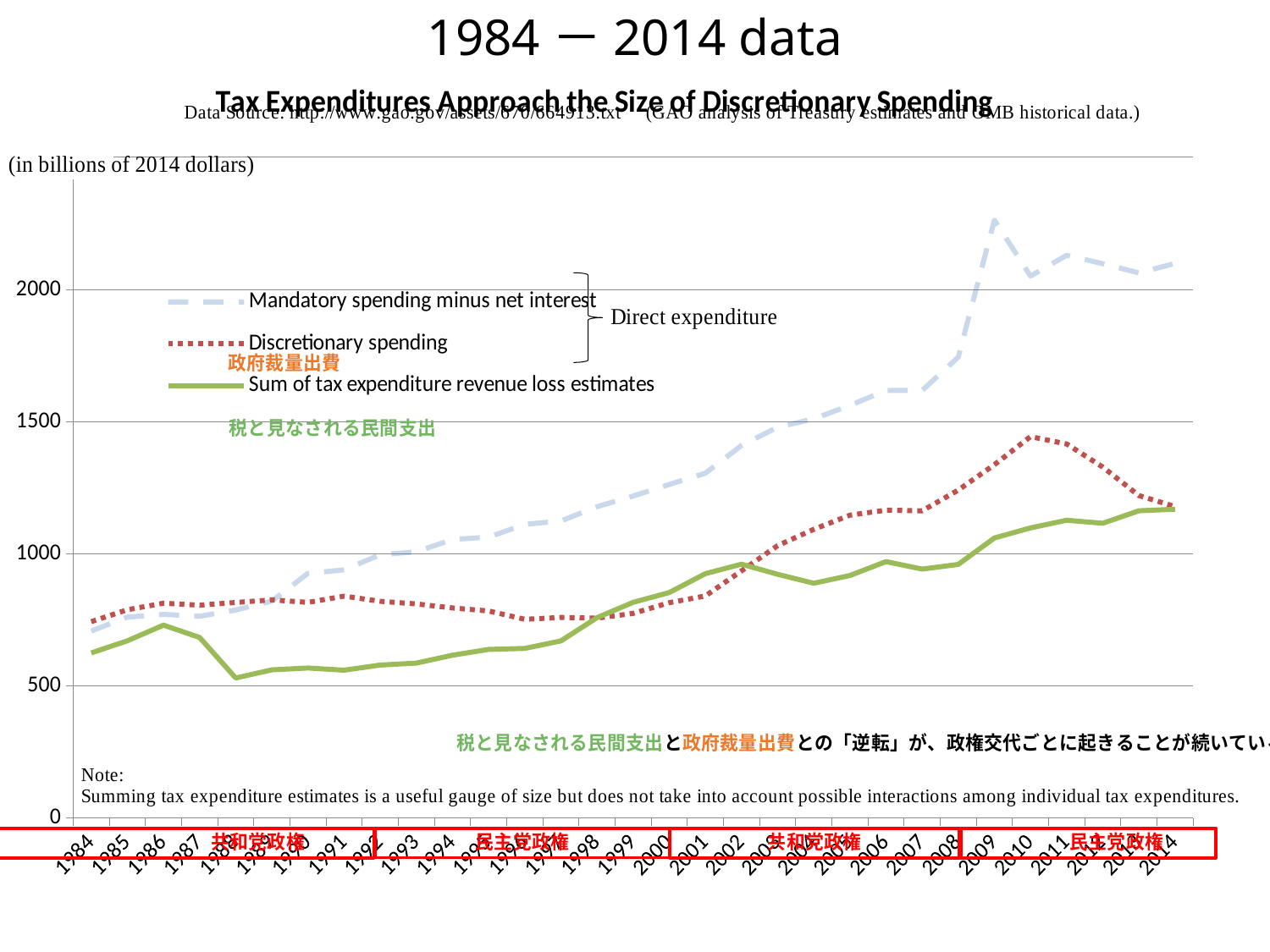
Which series is represented by the solid green line? Sum of tax expenditure revenue loss estimates Which series has the highest value in 2014? Mandatory spending minus net interest How many years are shown along the x axis? 31 What kind of chart is shown on the slide? line chart What unit is stated for the values on the chart? in billions of 2014 dollars In 2005, which is larger: Discretionary spending or Sum of tax expenditure revenue loss estimates? Discretionary spending How many series does the legend list? 3 Is the value for Sum of tax expenditure revenue loss estimates in 1988 greater or less than 1000? less Is the value for Discretionary spending in 2010 greater or less than 1000? greater Is the value for Mandatory spending minus net interest in 1984 greater or less than 1000? less In 2010, which is larger: Mandatory spending minus net interest or Discretionary spending? Mandatory spending minus net interest